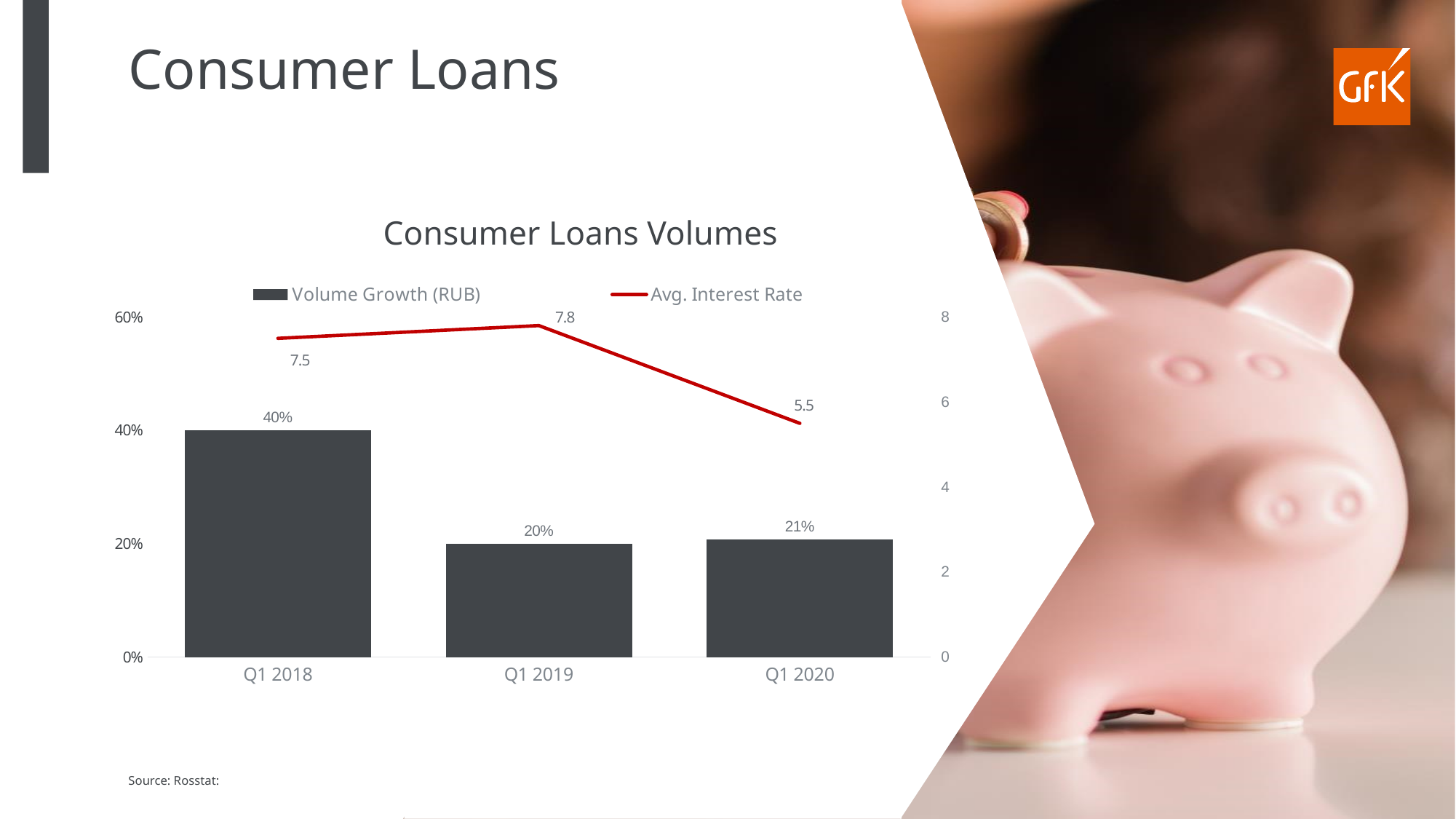
What is the Volume Growth (RUB) for Q1 2019? 20% What is the Avg. Interest Rate for Q1 2019? 7.8 What is the difference in Avg. Interest Rate between Q1 2019 and Q1 2020? 2.3 What is the title of the chart? Consumer Loans Volumes What is the Avg. Interest Rate for Q1 2020? 5.5 Which period has the lowest Avg. Interest Rate? Q1 2020 How many series does the legend list? 2 What is the Volume Growth (RUB) for Q1 2018? 40% Which period has the highest Volume Growth (RUB)? Q1 2018 Which is larger, the Avg. Interest Rate in Q1 2018 or in Q1 2019? Q1 2019 What is the difference in Volume Growth (RUB) between Q1 2018 and Q1 2019? 20% How many periods are shown on the x axis? 3